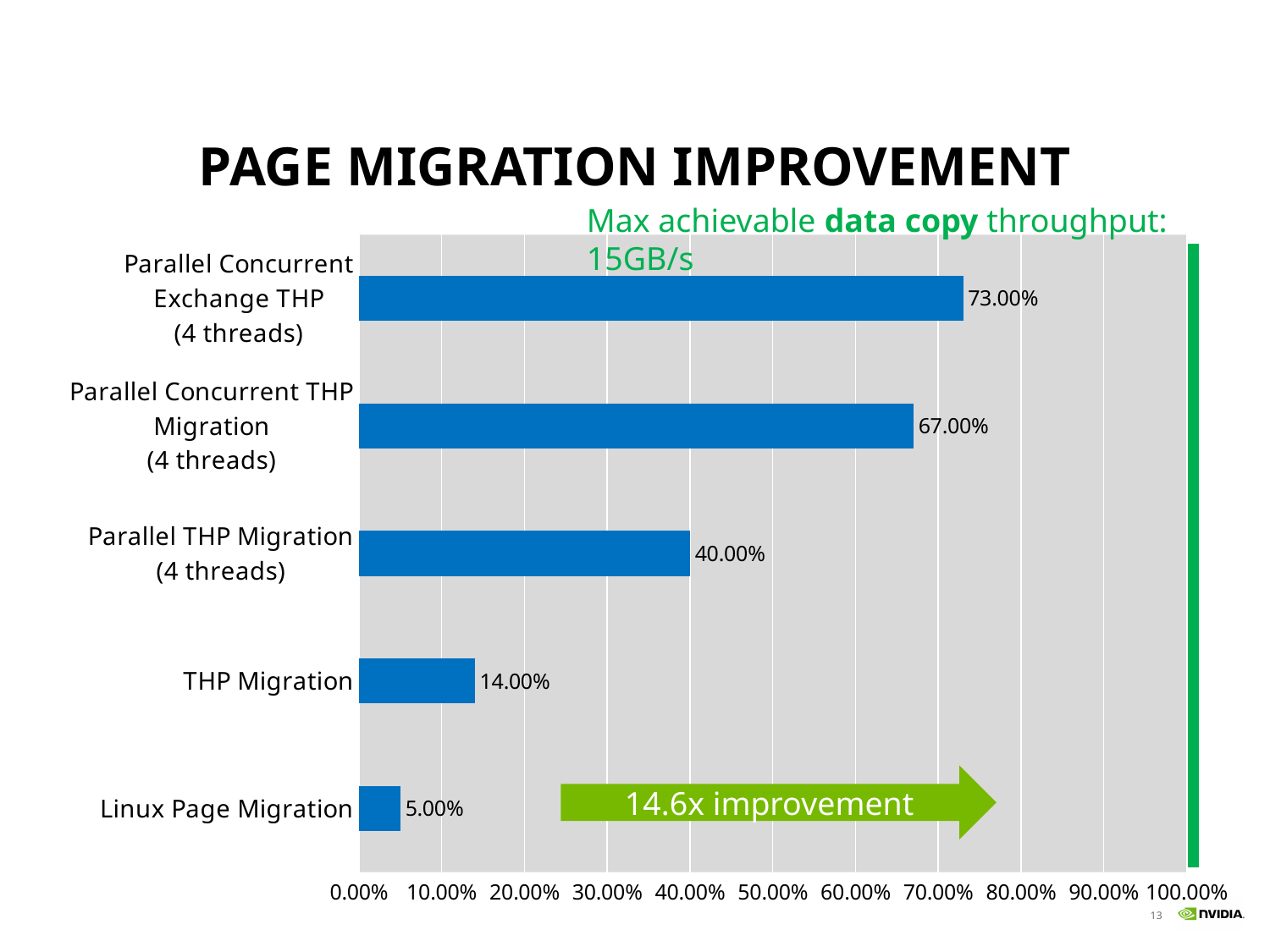
Which category has the lowest value? Linux Page Migration What is the difference between Parallel Concurrent Exchange THP (4 threads) and Parallel Concurrent THP Migration (4 threads)? 6.00% What is the value for Parallel Concurrent THP Migration (4 threads)? 67.00% What is the value for Parallel THP Migration (4 threads)? 40.00% Which is larger, the value for THP Migration or the value for Parallel THP Migration (4 threads)? Parallel THP Migration (4 threads) What is the value for Linux Page Migration? 5.00% Which category has the highest value? Parallel Concurrent Exchange THP (4 threads) What improvement factor is stated in the green arrow on the chart? 14.6x improvement How many categories are shown in the chart? 5 What kind of chart is shown on the slide? bar chart Is the value for Parallel Concurrent THP Migration (4 threads) greater or less than 60.00%? greater What is the value for THP Migration? 14.00%